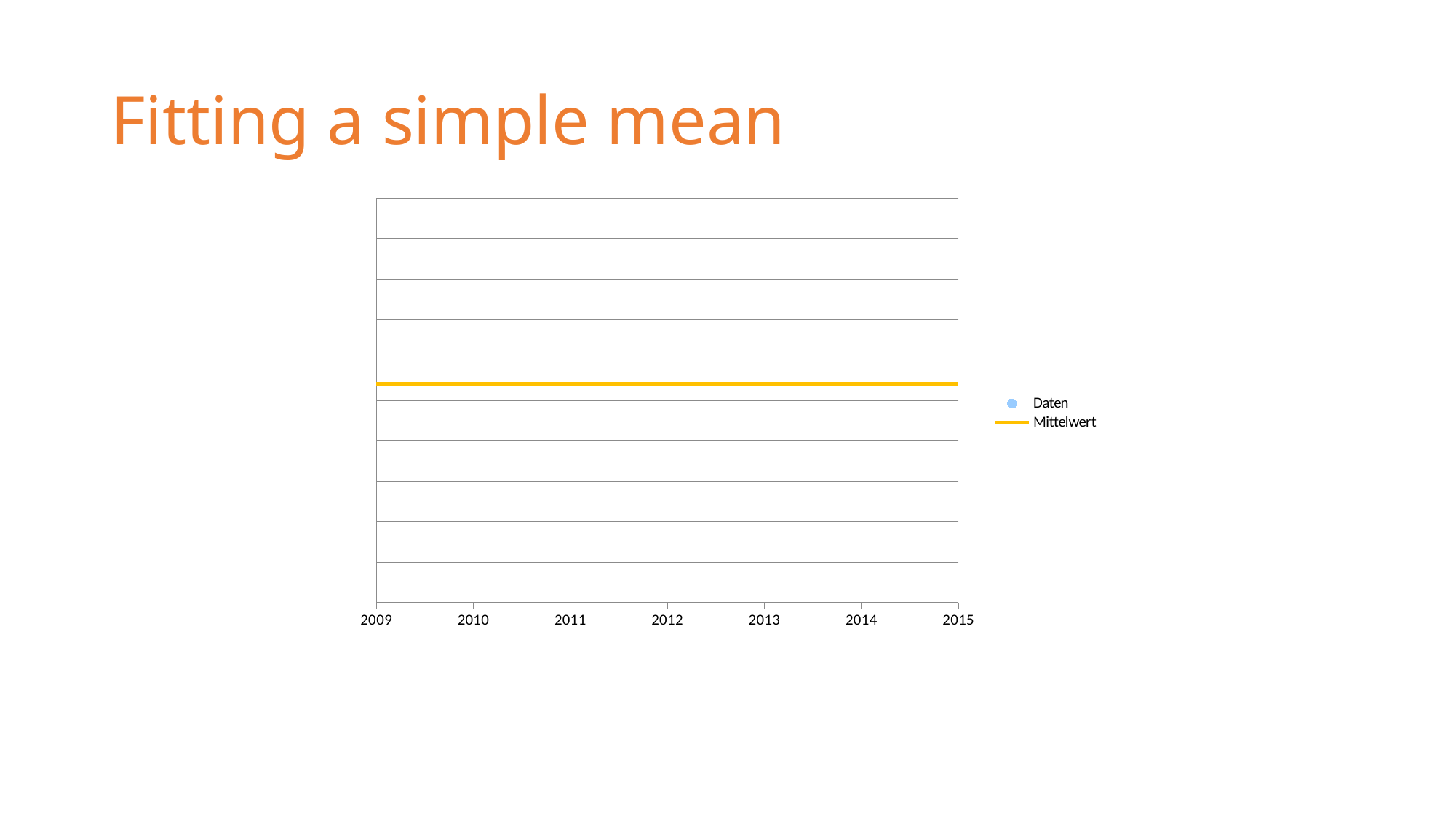
What is the first year shown on the x axis? 2009 Does the Mittelwert line rise, fall, or stay flat from 2009 to 2015? Stays flat What is the last year shown on the x axis? 2015 How many year labels are shown on the x axis? 7 What are the two entries in the chart legend? Daten and Mittelwert How many series does the legend list? 2 What colour is the Mittelwert line? Yellow What kind of chart is shown on the slide? Line chart